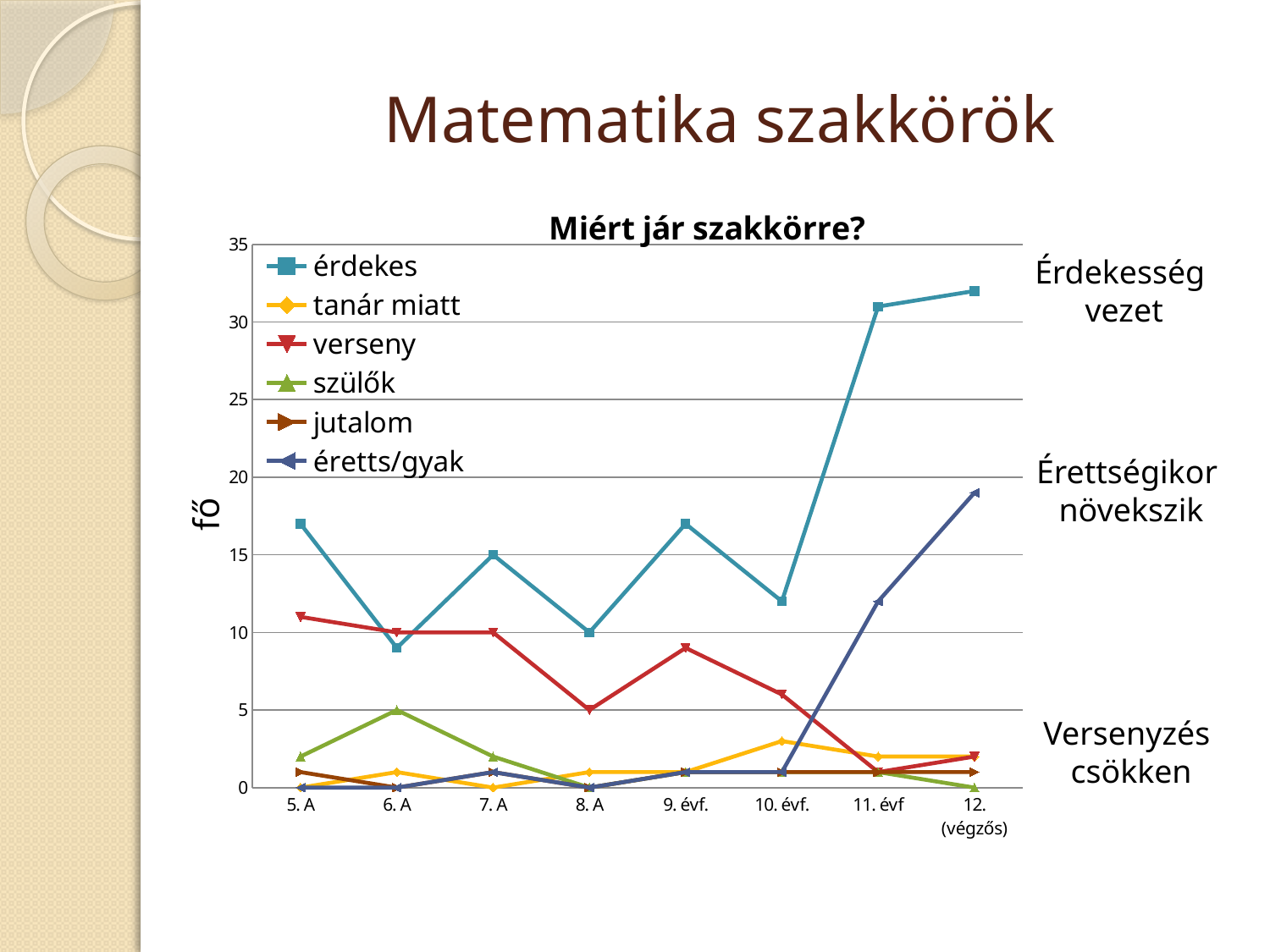
At 12. (végzős), which is larger: érdekes or éretts/gyak? érdekes Does the verseny series rise or fall from 9. évf. to 11. évf? fall At which category does the érdekes series reach its highest value? 12. (végzős) Is the value for érdekes at 12. (végzős) greater or less than 30? greater Is the value for éretts/gyak at 12. (végzős) greater or less than 15? greater What is the title of the chart? Miért jár szakkörre? How many categories are shown on the x axis? 8 What kind of chart is shown on the slide? line chart What is the value for szülők at 6. A? 5 What is the value for érdekes at 7. A? 15 How many series does the legend list? 6 What is the value for verseny at 8. A? 5